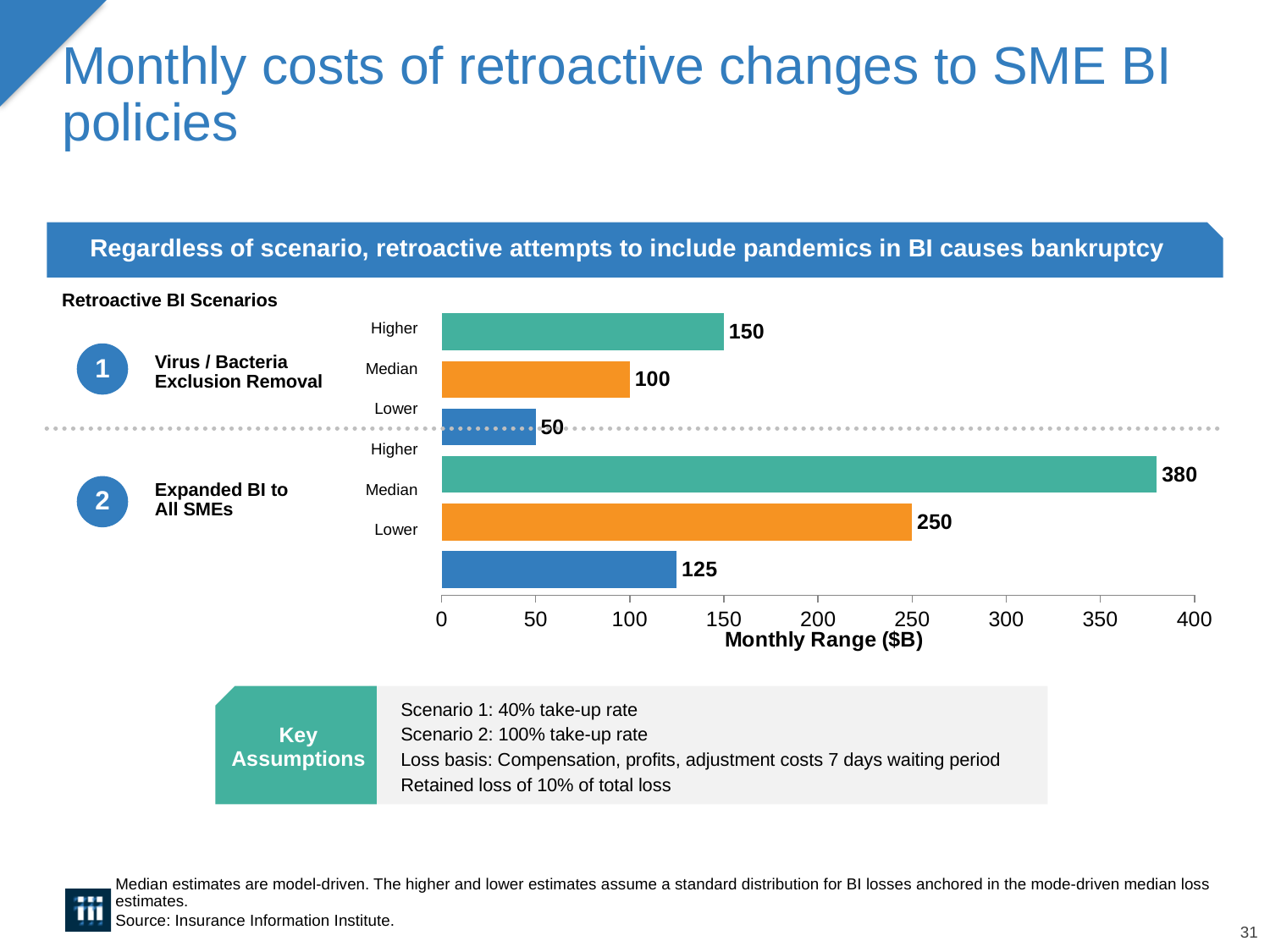
What kind of chart is shown on the slide? Bar chart What is the label of the horizontal axis? Monthly Range ($B) What is the Higher estimate for the Expanded BI to All SMEs scenario? 380 How many bars are plotted on the chart? 6 Which is larger: the Median estimate for scenario 1 or the Lower estimate for scenario 2? Lower estimate for scenario 2 What is the Higher estimate for the Virus / Bacteria Exclusion Removal scenario? 150 What is the Lower estimate for the Virus / Bacteria Exclusion Removal scenario? 50 What is the Median estimate for the Expanded BI to All SMEs scenario? 250 What is the difference between the Median and Lower estimates for the Expanded BI to All SMEs scenario? 125 Which bar has the lowest value on the chart? Virus / Bacteria Exclusion Removal, Lower What is the difference between the Higher estimates of scenario 2 and scenario 1? 230 Which bar has the highest value on the chart? Expanded BI to All SMEs, Higher